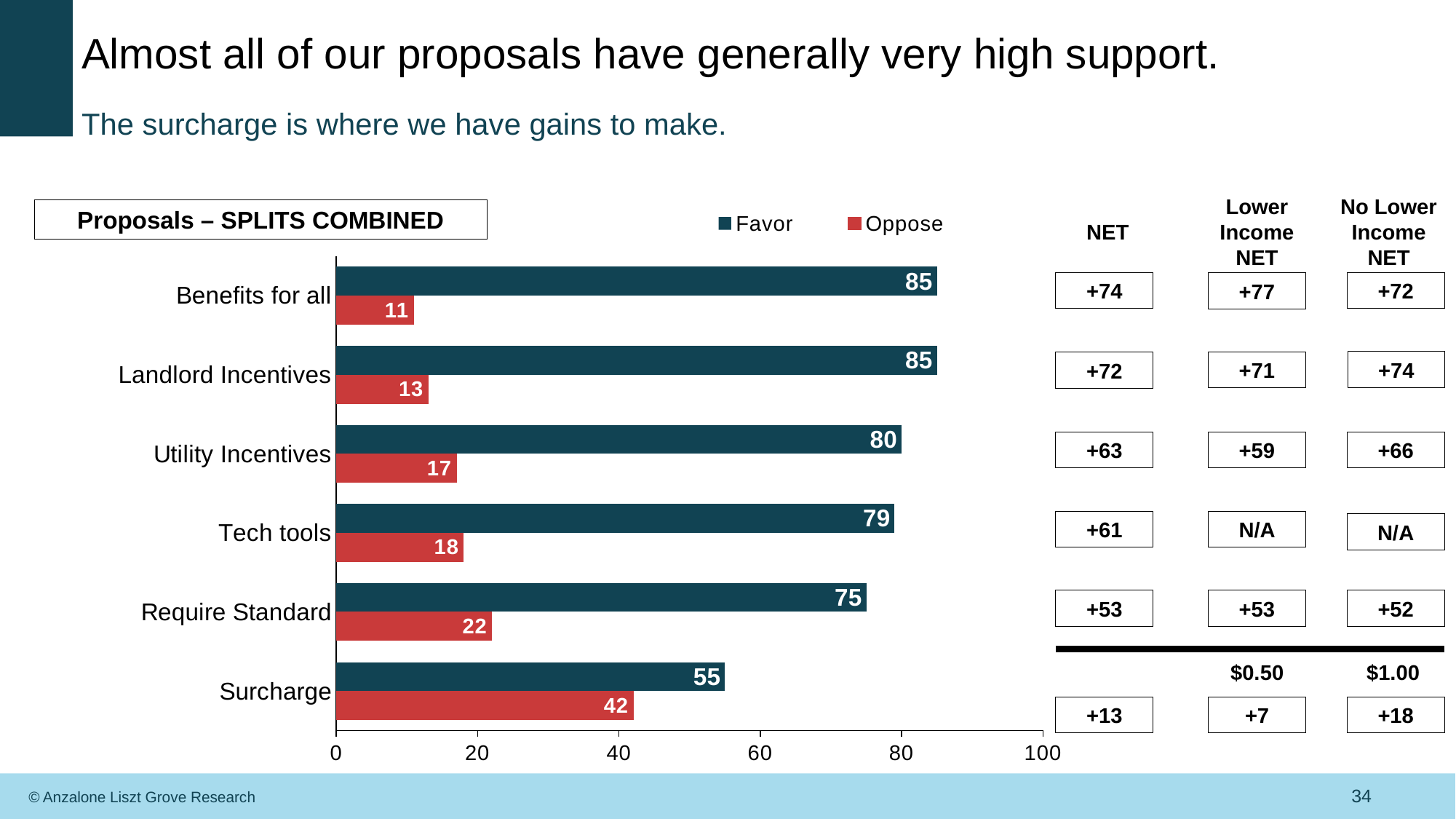
How many series does the legend list? 2 What is the difference between the Favor values for Landlord Incentives and Tech tools? 6 What is the difference between the Favor and Oppose values for Require Standard? 53 What is the Oppose value for Benefits for all? 11 What is the Favor value for Utility Incentives? 80 What is the Oppose value for Surcharge? 42 Which proposal has the lowest Favor value? Surcharge Which proposal has the highest Oppose value? Surcharge What kind of chart is shown on the slide? Bar chart What is the title shown in the box above the chart? Proposals – SPLITS COMBINED How many proposals are shown in the chart? 6 Which is larger, the Oppose value for Tech tools or the Oppose value for Utility Incentives? Tech tools